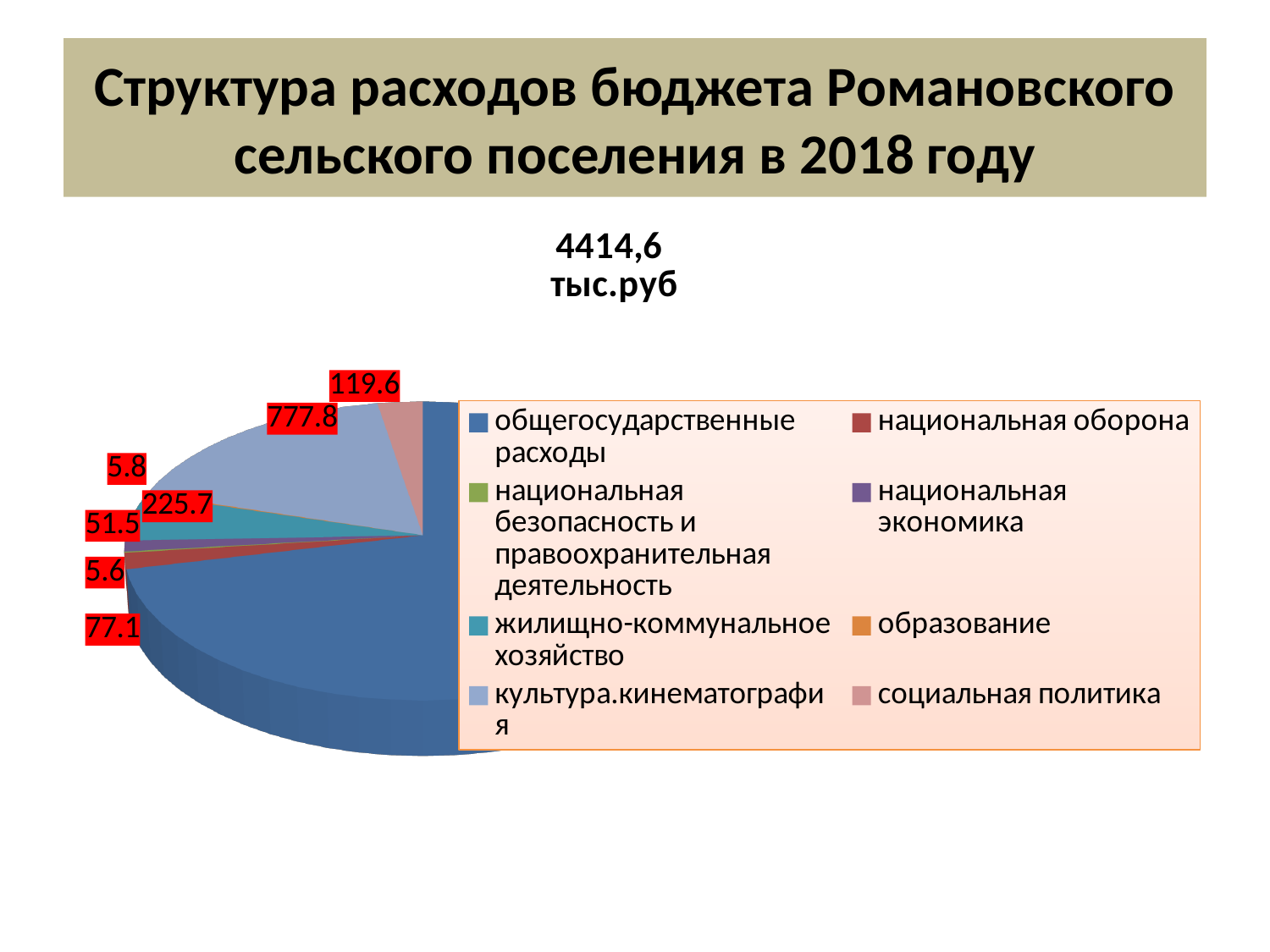
What is the difference between the values for культура.кинематография (777.8) and социальная политика (119.6)? 658.2 What value is labelled for the жилищно-коммунальное хозяйство slice? 225.7 How many categories does the legend of the pie chart list? 8 What year does the slide title say the budget expenditure structure refers to? 2018 What value is labelled for the социальная политика slice? 119.6 What value is labelled for the национальная оборона slice? 77.1 What total amount is printed above the pie chart? 4414,6 тыс.руб What type of chart is shown on the slide? pie chart Which category has the largest slice of the pie? общегосударственные расходы What value is labelled for the культура.кинематография slice? 777.8 What is the difference between the values for жилищно-коммунальное хозяйство (225.7) and национальная оборона (77.1)? 148.6 Which is larger, the value for культура.кинематография or for социальная политика? культура.кинематография